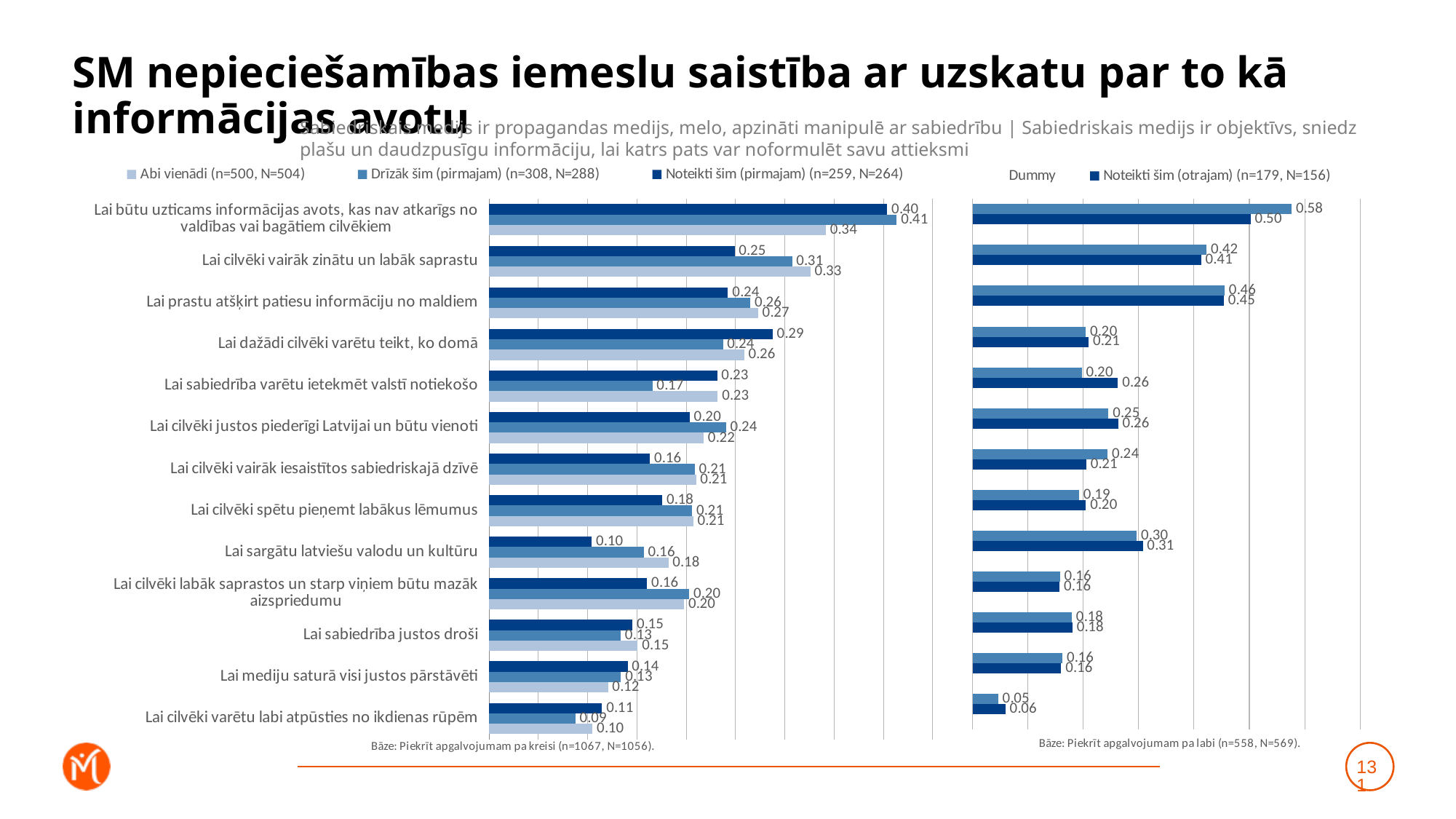
What kind of chart is the left chart? Bar chart In the left chart, what is the difference between 'Drīzāk šim (pirmajam)' and 'Noteikti šim (pirmajam)' for 'Lai sargātu latviešu valodu un kultūru'? 0.06 How many series does the legend of the left chart list? 3 In the right chart, which category has the lowest 'Noteikti šim (otrajam)' value? Lai cilvēki varētu labi atpūsties no ikdienas rūpēm How many categories are shown in the left chart? 13 In the right chart, which category has the highest 'Noteikti šim (otrajam)' value? Lai būtu uzticams informācijas avots, kas nav atkarīgs no valdības vai bagātiem cilvēkiem In the left chart, what is the value of 'Noteikti šim (pirmajam)' for 'Lai dažādi cilvēki varētu teikt, ko domā'? 0.29 In the left chart, which category has the highest 'Abi vienādi' value? Lai būtu uzticams informācijas avots, kas nav atkarīgs no valdības vai bagātiem cilvēkiem In the left chart, what is the value of 'Abi vienādi' for 'Lai būtu uzticams informācijas avots, kas nav atkarīgs no valdības vai bagātiem cilvēkiem'? 0.34 In the right chart, what is the value of 'Noteikti šim (otrajam)' for 'Lai būtu uzticams informācijas avots, kas nav atkarīgs no valdības vai bagātiem cilvēkiem'? 0.50 In the right chart, what is the value of 'Noteikti šim (otrajam)' for 'Lai sargātu latviešu valodu un kultūru'? 0.31 In the left chart, for 'Lai sabiedrība varētu ietekmēt valstī notiekošo', which is larger: 'Noteikti šim (pirmajam)' or 'Drīzāk šim (pirmajam)'? Noteikti šim (pirmajam)